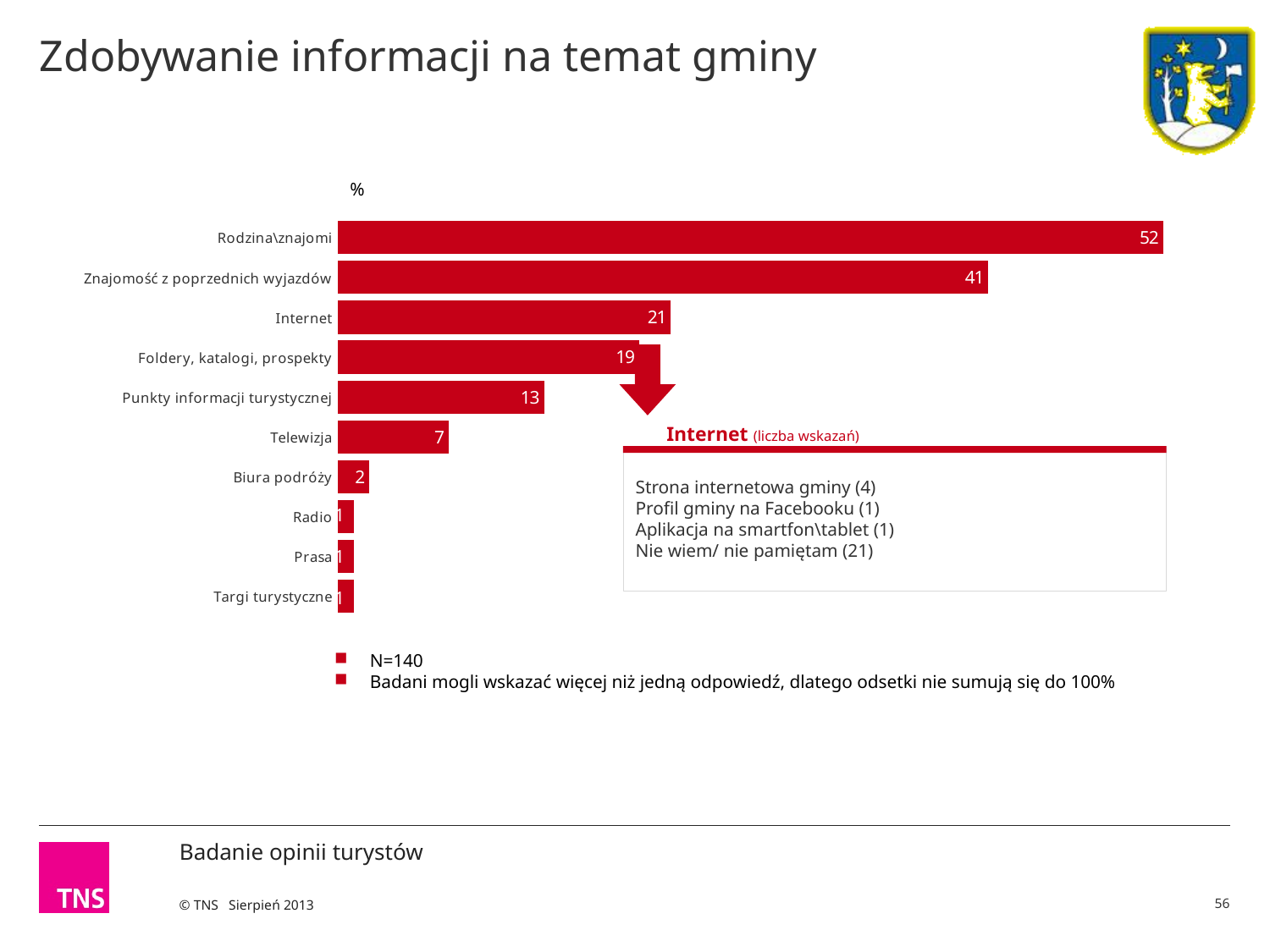
How many categories are shown in the chart? 10 What is the difference between the values for Rodzina\znajomi and Znajomość z poprzednich wyjazdów? 11 What is the value for Rodzina\znajomi? 52 Which category has the highest value? Rodzina\znajomi What kind of chart is shown on the slide? bar chart Which is larger, the value for Punkty informacji turystycznej or the value for Telewizja? Punkty informacji turystycznej What is the difference between the values for Internet and Foldery, katalogi, prospekty? 2 What unit is indicated above the chart? % What is the value for Znajomość z poprzednich wyjazdów? 41 What is the value for Internet? 21 What is the value for Punkty informacji turystycznej? 13 What is the value for Telewizja? 7